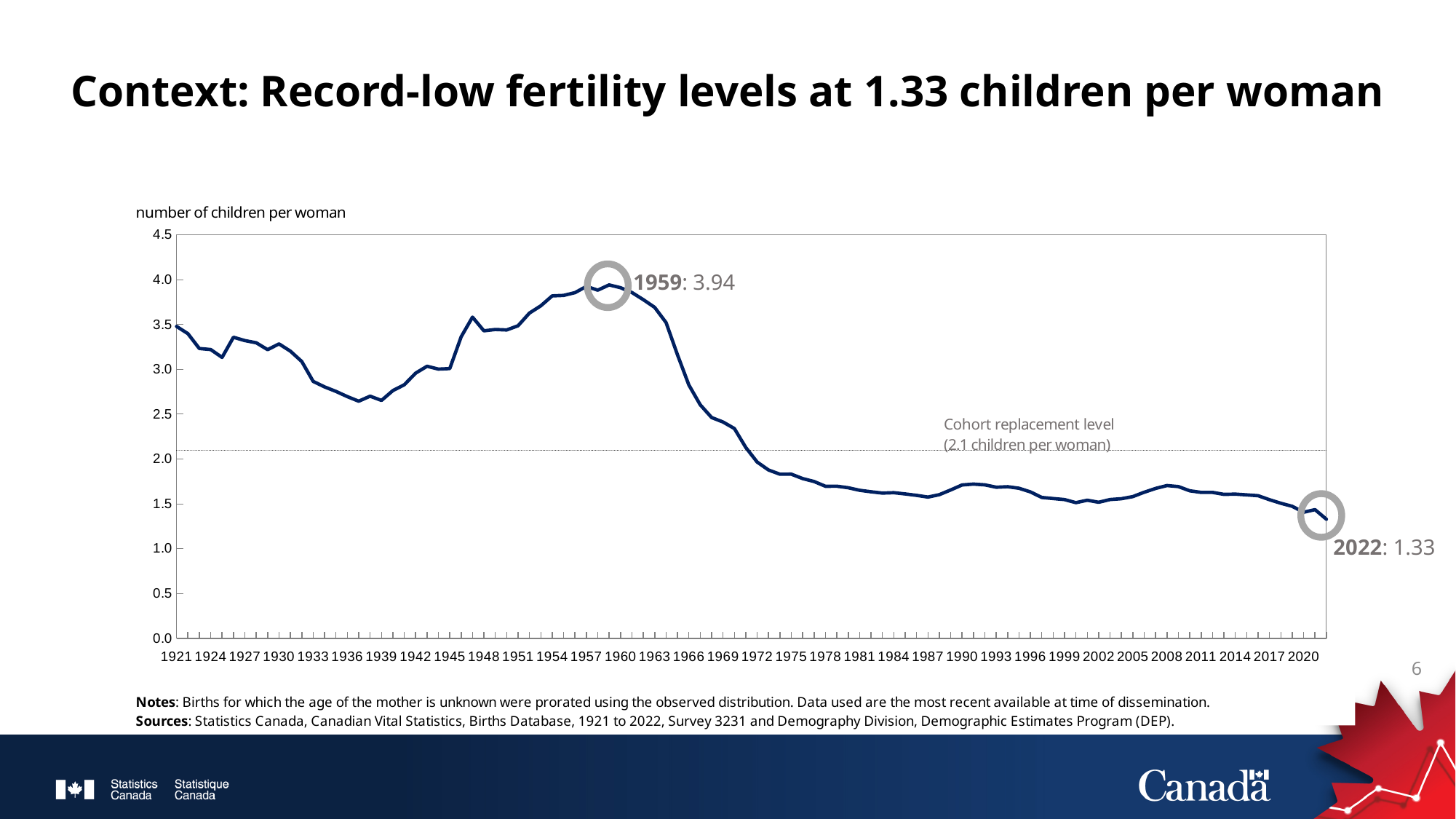
What was the fertility rate in 2022 according to the chart? 1.33 In which year does the chart mark the highest number of children per woman? 1959 Does the number of children per woman rise or fall between 1959 and 1972? fall In which year does the chart mark the lowest number of children per woman? 2022 Is the value for 1937 greater or less than 3.0? less What was the fertility rate in 1959 according to the chart? 3.94 What is the difference between the 1959 value and the 2022 value? 2.61 What value does the dotted horizontal line labelled cohort replacement level represent? 2.1 children per woman Is the value for 1921 greater or less than 3.0? greater Which year has the higher value, 1959 or 2022? 1959 Is the value for 1975 greater or less than 2.0? less What kind of chart is shown on the slide? line chart